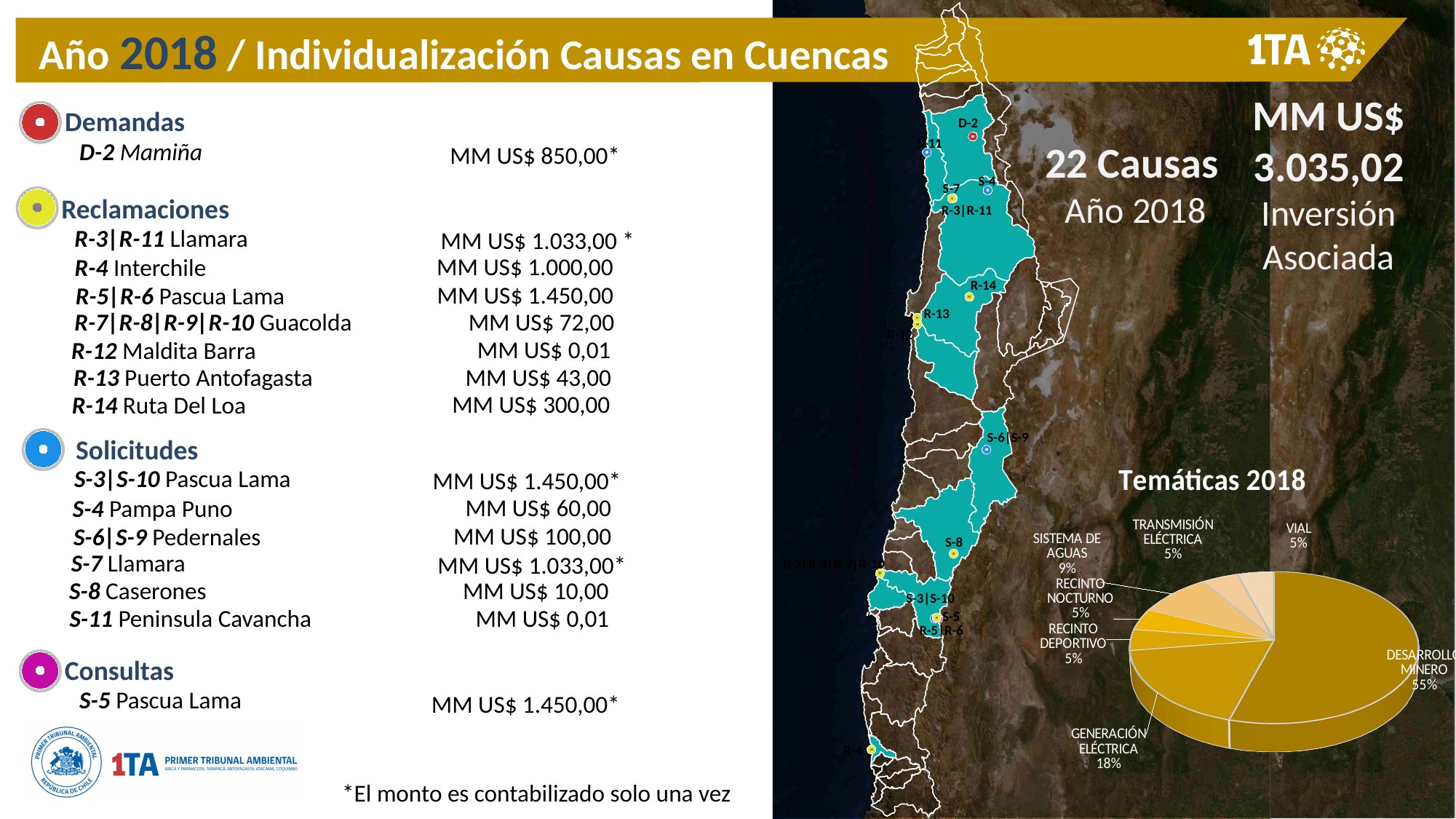
What is the title of the pie chart on the slide? Temáticas 2018 What kind of chart is the "Temáticas 2018" chart? pie chart In the "Temáticas 2018" pie chart, what share does Recinto Deportivo have? 5% In the "Temáticas 2018" pie chart, which is larger: Generación Eléctrica or Sistema de Aguas? Generación Eléctrica In the "Temáticas 2018" pie chart, what share does Transmisión Eléctrica have? 5% In the "Temáticas 2018" pie chart, what share does Generación Eléctrica have? 18% In the "Temáticas 2018" pie chart, how many slices are there? 7 In the "Temáticas 2018" pie chart, which category has the largest share? Desarrollo Minero In the "Temáticas 2018" pie chart, what is the difference in percentage points between Desarrollo Minero and Generación Eléctrica? 37